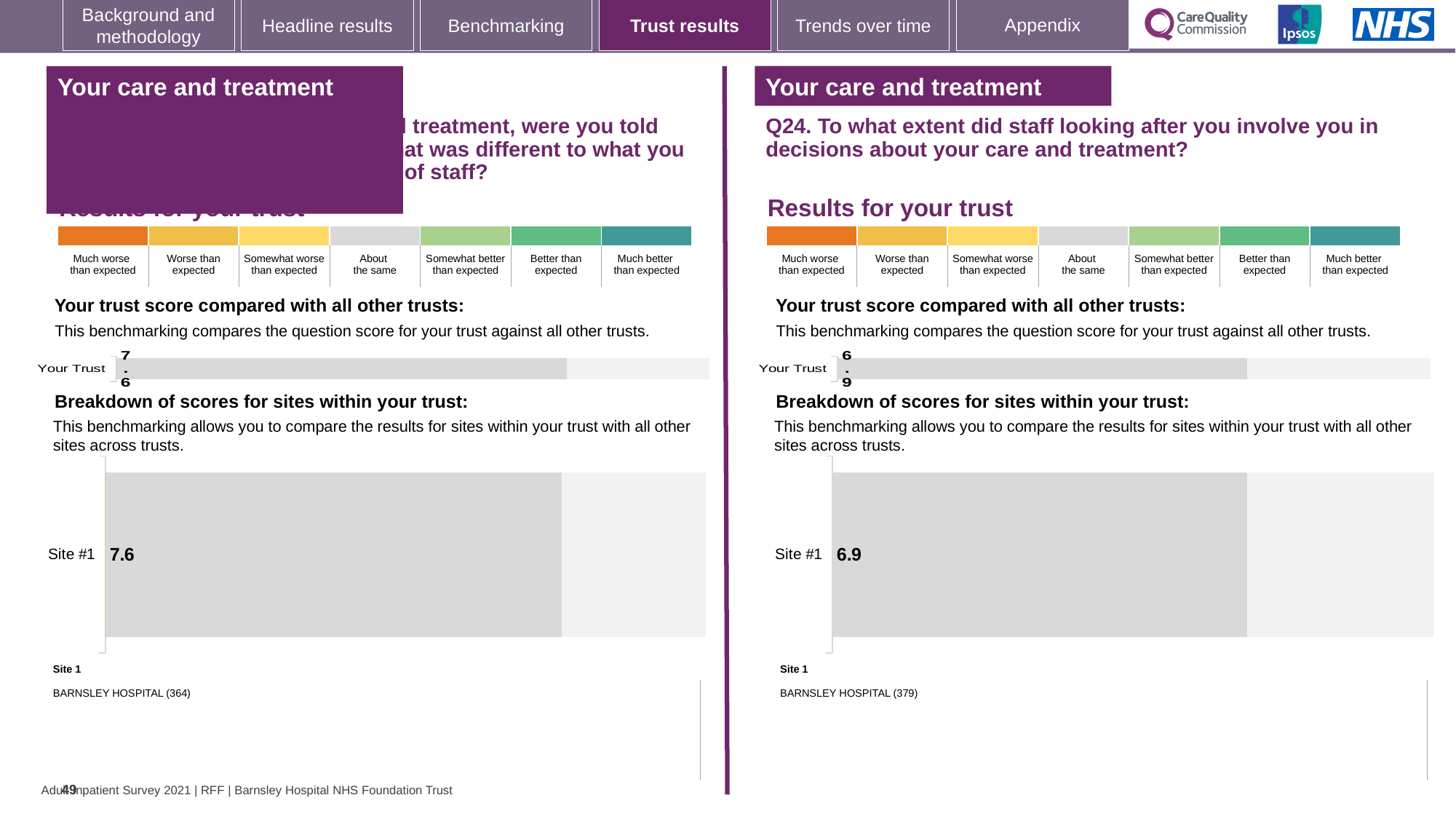
On the left half of the slide, what is the score shown for Your Trust in the trust benchmarking bar? 7.6 What kind of chart is used to show the Site #1 score on the right half of the slide? Bar chart What is the difference between the Site #1 score on the left half of the slide and the Site #1 score on the right half (Q24)? 0.7 On the right half of the slide, is the Site #1 score the same as the Your Trust score? Yes, both are 6.9 Which Site #1 score is larger: the one on the left half of the slide or the one on the right half (Q24)? Left half (7.6) On the right half of the slide (Q24), what is the score shown for Site #1? 6.9 On the right half of the slide, which hospital is listed as Site 1 below the chart? BARNSLEY HOSPITAL (379) On the left half of the slide, what is the score shown for Site #1? 7.6 On the left half of the slide, which hospital is listed as Site 1 below the chart? BARNSLEY HOSPITAL (364) On the right half of the slide (Q24), what is the score shown for Your Trust in the trust benchmarking bar? 6.9 How many sites are shown in the site breakdown chart on the right half of the slide (Q24)? 1 How many sites are shown in the site breakdown chart on the left half of the slide? 1